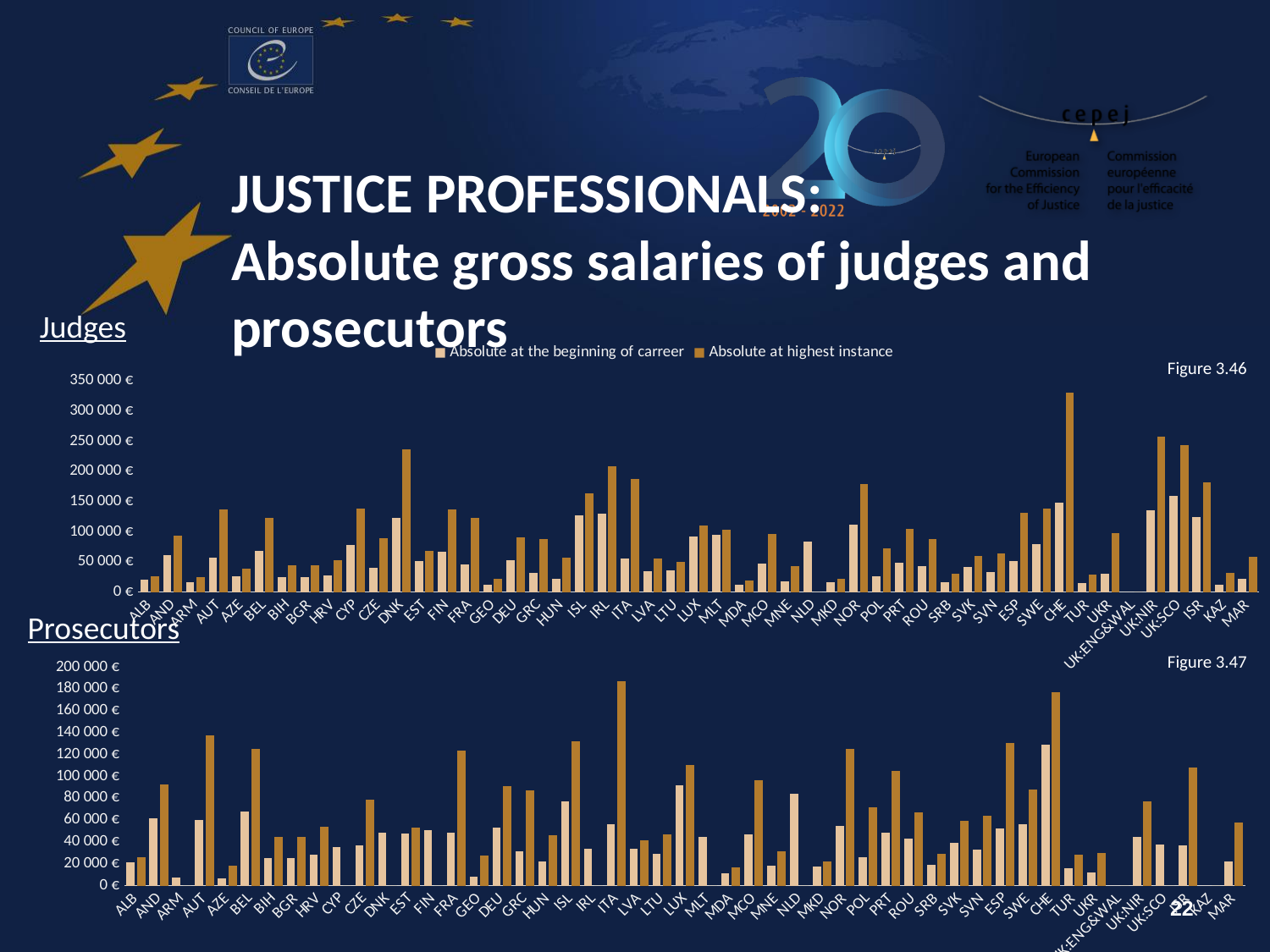
In the Prosecutors chart (Figure 3.47), is the 'Absolute at highest instance' value for ITA greater or less than 160 000 €? greater In the Prosecutors chart (Figure 3.47), which is larger: the 'Absolute at highest instance' value for ITA or for AUT? ITA In the Judges chart (Figure 3.46), is the 'Absolute at the beginning of carreer' value for ALB greater or less than 50 000 €? less In the Judges chart (Figure 3.46), is the 'Absolute at highest instance' value for UK:SCO greater or less than 200 000 €? greater What kind of chart is the Prosecutors chart (Figure 3.47)? bar chart In the Judges chart (Figure 3.46), which country has the highest 'Absolute at highest instance' salary? CHE What are the two series named in the legend of the Judges chart? Absolute at the beginning of carreer; Absolute at highest instance What kind of chart is the Judges chart (Figure 3.46)? bar chart How many series does the legend of the Judges chart list? 2 In the Judges chart (Figure 3.46), which is larger: the 'Absolute at highest instance' value for CHE or for ITA? CHE